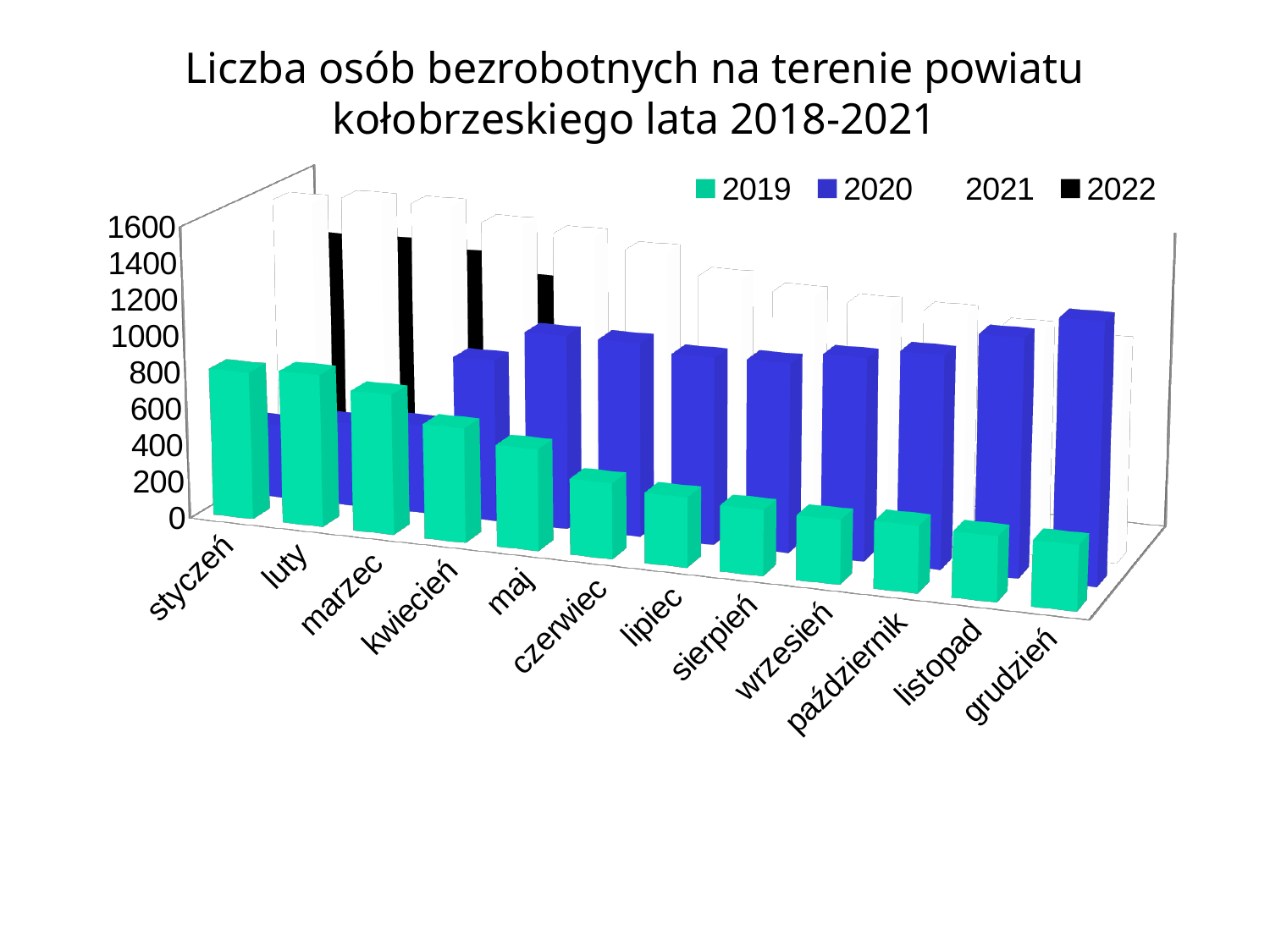
What colour are the bars for the 2019 series? green Is the value for styczeń in the 2019 series greater or less than 400? greater How many months are shown along the x axis? 12 Do the values for the 2020 series rise or fall from kwiecień to grudzień? rise For grudzień, which series has the larger value: 2019 or 2020? 2020 How many series does the legend list? 4 Do the values for the 2019 series rise or fall from styczeń to grudzień? fall What kind of chart is shown on the slide? bar chart Which years are listed in the legend? 2019, 2020, 2021, 2022 For the 2019 series, which is larger: the value for styczeń or the value for grudzień? styczeń Which month has the highest value for the 2020 series? grudzień For how many months are bars shown for the 2022 series? 4